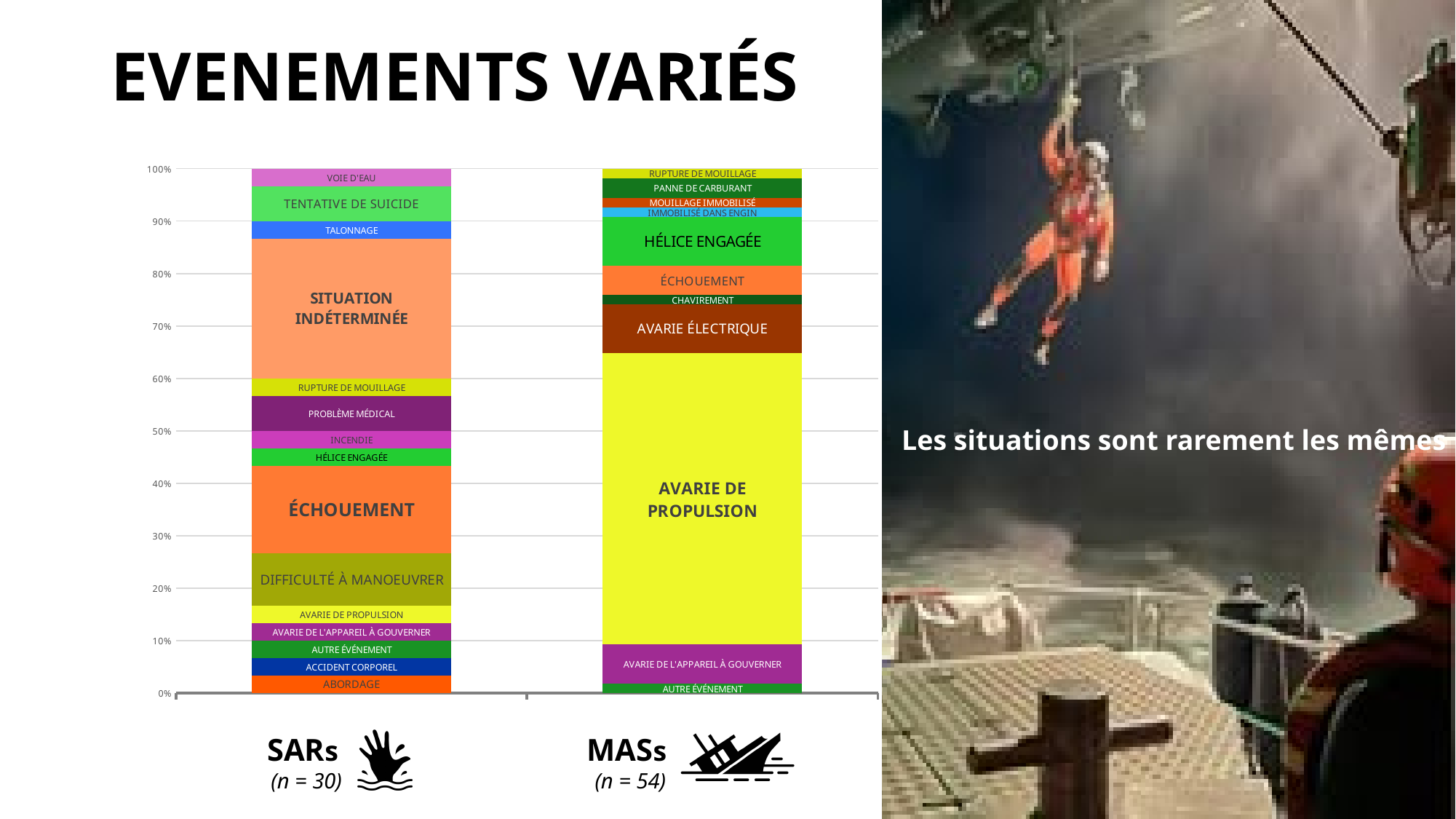
What kind of chart is shown on the slide? Stacked bar chart What sample size (n) is given for the MASs bar? n = 54 Is the share of ÉCHOUEMENT in the SARs bar greater or less than 10%? greater How many bars does the chart contain? 2 Which segment is the largest in the MASs bar? AVARIE DE PROPULSION Which segment is the largest in the SARs bar? SITUATION INDÉTERMINÉE In the SARs bar, which segment is larger: ÉCHOUEMENT or DIFFICULTÉ À MANOEUVRER? ÉCHOUEMENT Is the share of SITUATION INDÉTERMINÉE in the SARs bar greater or less than 20%? greater How many segments make up the MASs bar? 11 In the MASs bar, which segment is larger: AVARIE ÉLECTRIQUE or CHAVIREMENT? AVARIE ÉLECTRIQUE Is the share of AVARIE DE PROPULSION in the MASs bar greater or less than 50%? greater What is the title of the slide containing the chart? EVENEMENTS VARIÉS